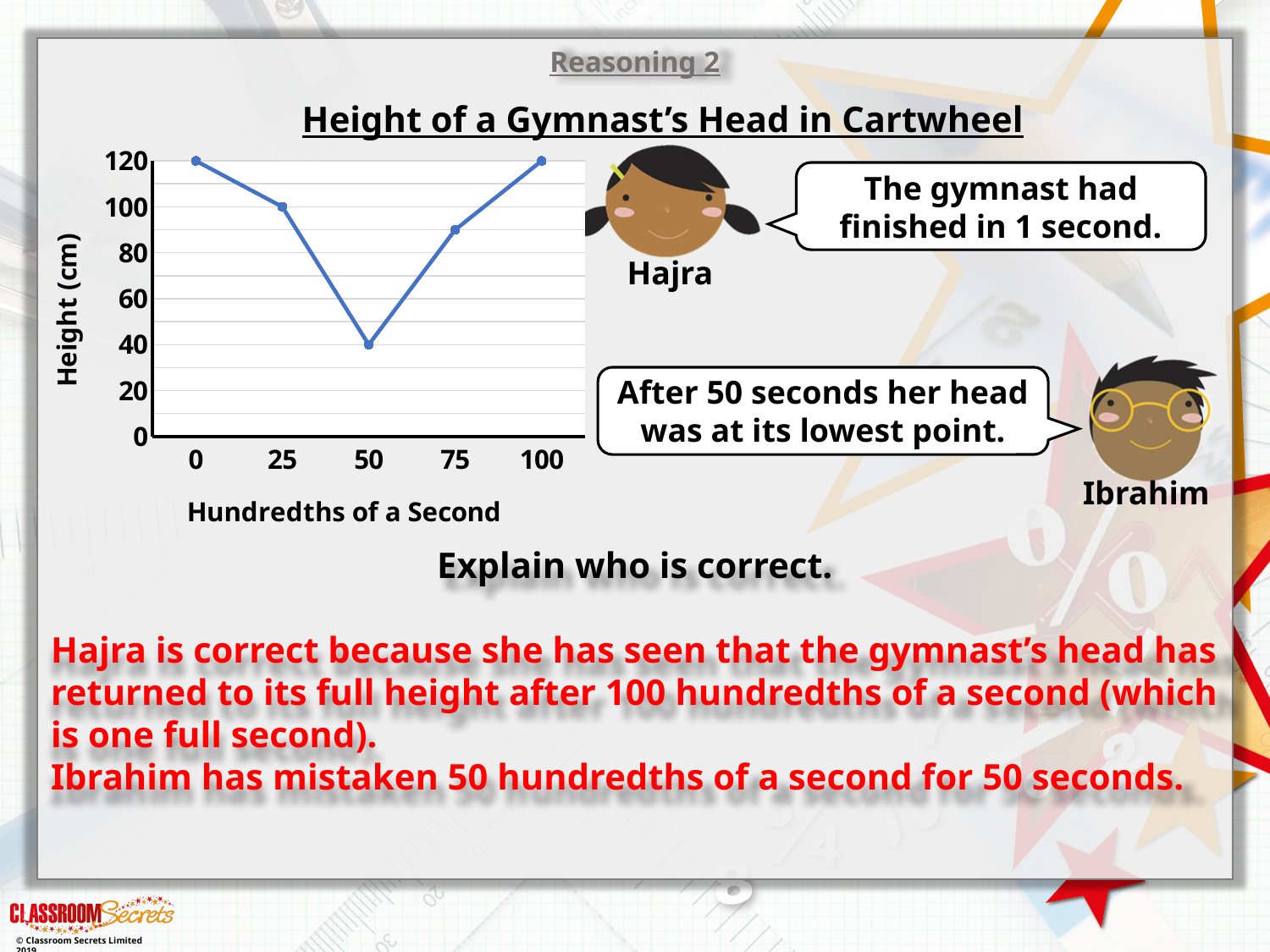
What is the height at 100 hundredths of a second? 120 At which time (in hundredths of a second) is the height lowest? 50 How many data points are plotted on the line? 5 What is the title of the chart? Height of a Gymnast's Head in Cartwheel What is the label of the x axis? Hundredths of a Second What is the height at 0 hundredths of a second? 120 Does the height rise or fall between 0 and 50 hundredths of a second? fall What kind of chart is shown on the slide? line chart What is the difference between the height at 0 and the height at 50 hundredths of a second? 80 Is the height at 75 hundredths of a second greater or less than 80? greater What is the height at 25 hundredths of a second? 100 What is the height at 50 hundredths of a second? 40